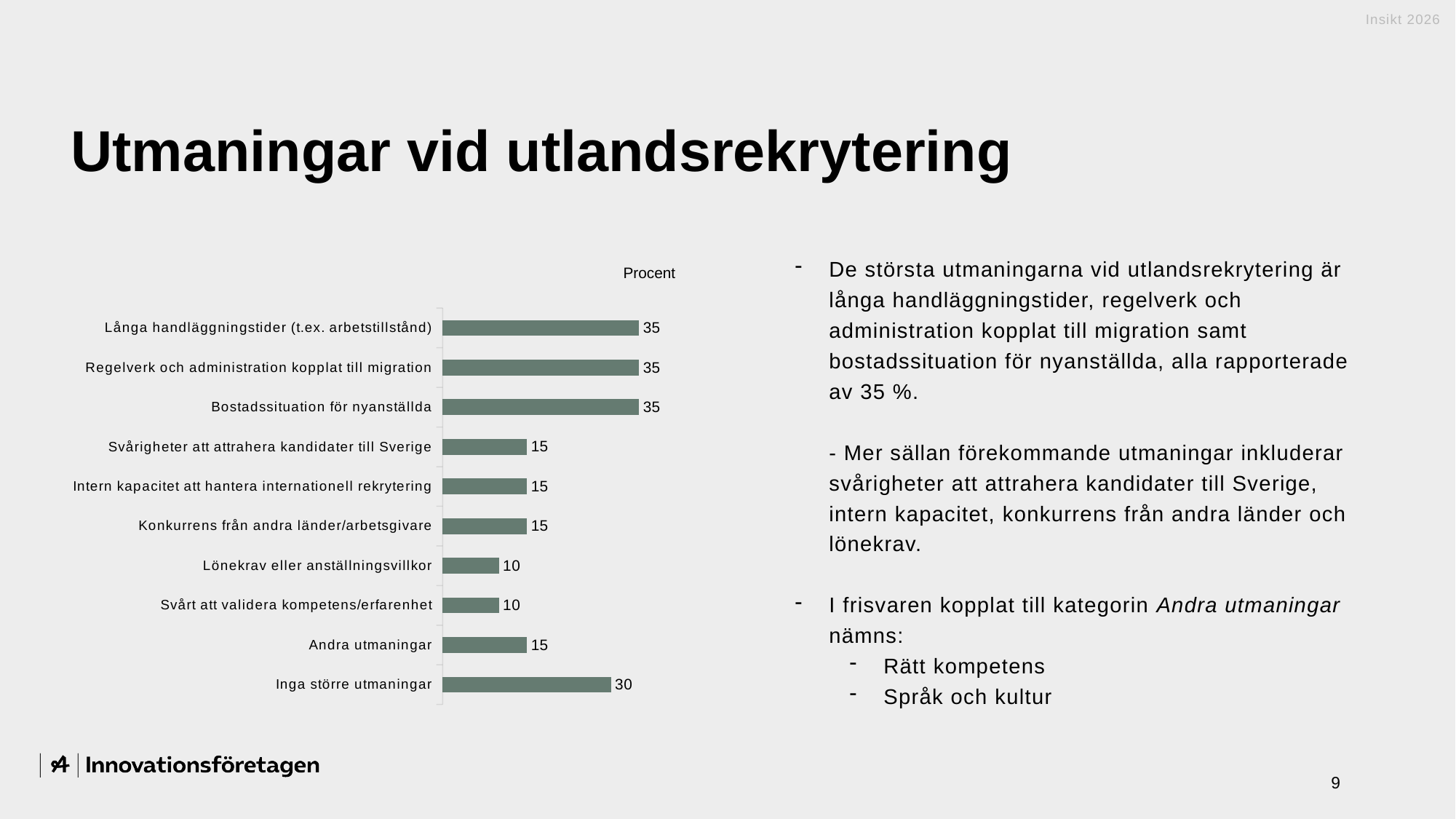
What is the difference between the values for Regelverk och administration kopplat till migration and Lönekrav eller anställningsvillkor? 25 How many categories are shown in the chart? 10 What kind of chart is shown on the slide? Bar chart What is the value for Svårt att validera kompetens/erfarenhet? 10 Which is larger, the value for Inga större utmaningar or the value for Konkurrens från andra länder/arbetsgivare? Inga större utmaningar What is the title of the chart? Procent What is the value for Långa handläggningstider (t.ex. arbetstillstånd)? 35 What is the value for Lönekrav eller anställningsvillkor? 10 What is the value for Inga större utmaningar? 30 Which is larger, the value for Svårigheter att attrahera kandidater till Sverige or the value for Svårt att validera kompetens/erfarenhet? Svårigheter att attrahera kandidater till Sverige What is the difference between the values for Bostadssituation för nyanställda and Inga större utmaningar? 5 What is the value for Andra utmaningar? 15